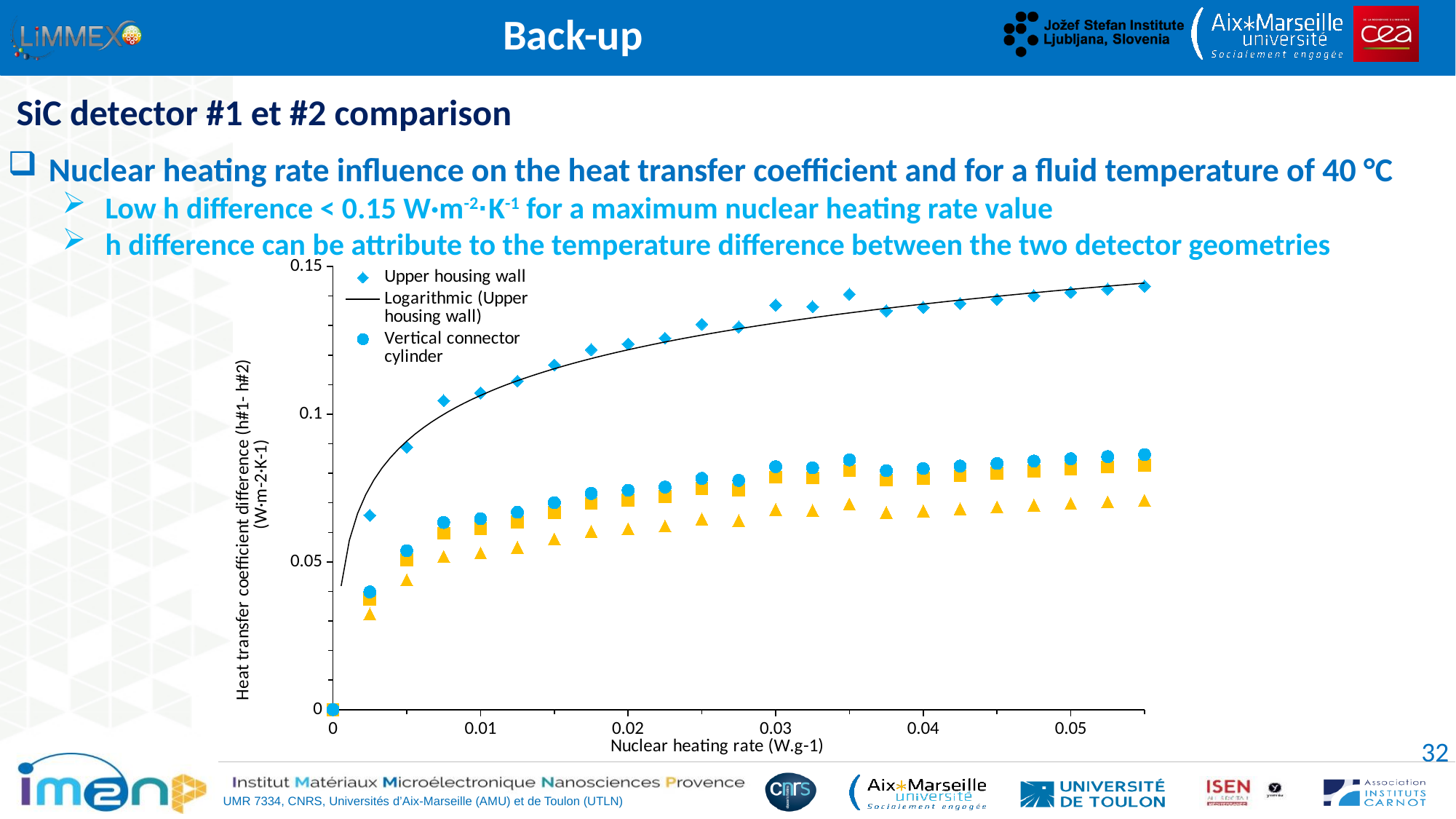
How many entries does the chart legend list? 3 Is the Upper housing wall value at a nuclear heating rate of 0.02 greater or less than 0.1? greater What is the label of the x axis of the chart? Nuclear heating rate (W.g-1) Do the Upper housing wall values rise or fall as the nuclear heating rate increases? rise Do the Vertical connector cylinder values rise or fall as the nuclear heating rate increases? rise Is the Vertical connector cylinder value at a nuclear heating rate of 0.01 greater or less than 0.05? greater Is the Upper housing wall value at a nuclear heating rate of 0.05 greater or less than 0.1? greater At a nuclear heating rate of 0.03, which series has the larger value: Upper housing wall or Vertical connector cylinder? Upper housing wall What kind of chart is shown on the slide? scatter chart Which series is drawn as a solid black line in the chart? Logarithmic (Upper housing wall) What is the highest value shown on the y axis of the chart? 0.15